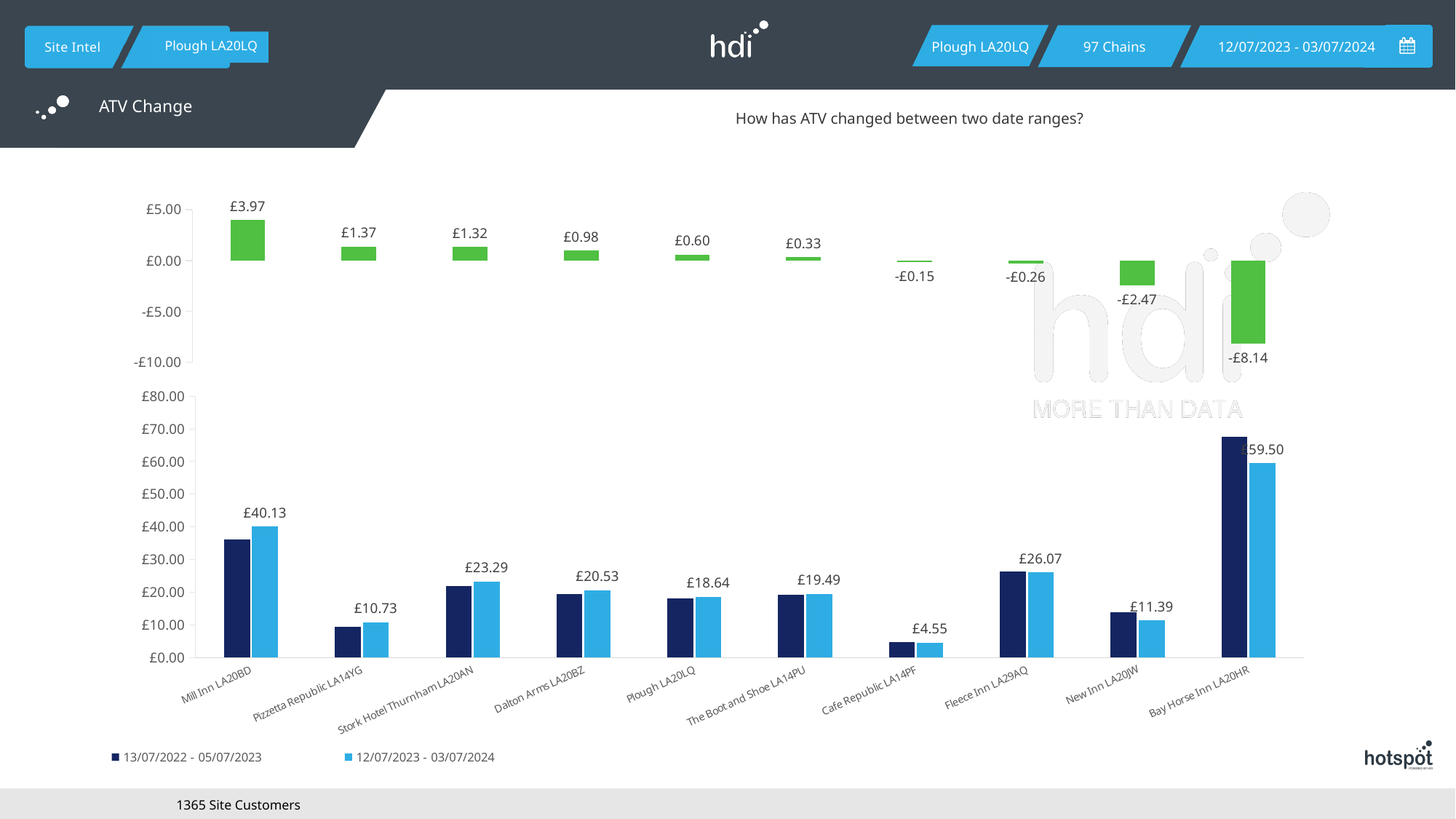
What type of chart is the bottom chart? Bar chart In the bottom chart, is the 13/07/2022 - 05/07/2023 value for Bay Horse Inn LA20HR greater or less than £60.00? greater In the top chart, what is the ATV change for Mill Inn LA20BD? £3.97 In the top chart, what is the difference between the ATV change for Pizzetta Republic LA14YG and Stork Hotel Thurnham LA20AN? £0.05 In the top chart, which site has the lowest ATV change? Bay Horse Inn LA20HR In the bottom chart, which is larger for Fleece Inn LA29AQ: the 12/07/2023 - 03/07/2024 value or the 12/07/2023 - 03/07/2024 value for New Inn LA20JW? Fleece Inn LA29AQ In the bottom chart, what is the value for Bay Horse Inn LA20HR in the 12/07/2023 - 03/07/2024 series? £59.50 In the top chart, what is the ATV change for Bay Horse Inn LA20HR? -£8.14 In the top chart, which site has the highest ATV change? Mill Inn LA20BD In the bottom chart, how many series does the legend list? 2 In the top chart, how many sites are plotted? 10 In the bottom chart, what is the value for Cafe Republic LA14PF in the 12/07/2023 - 03/07/2024 series? £4.55